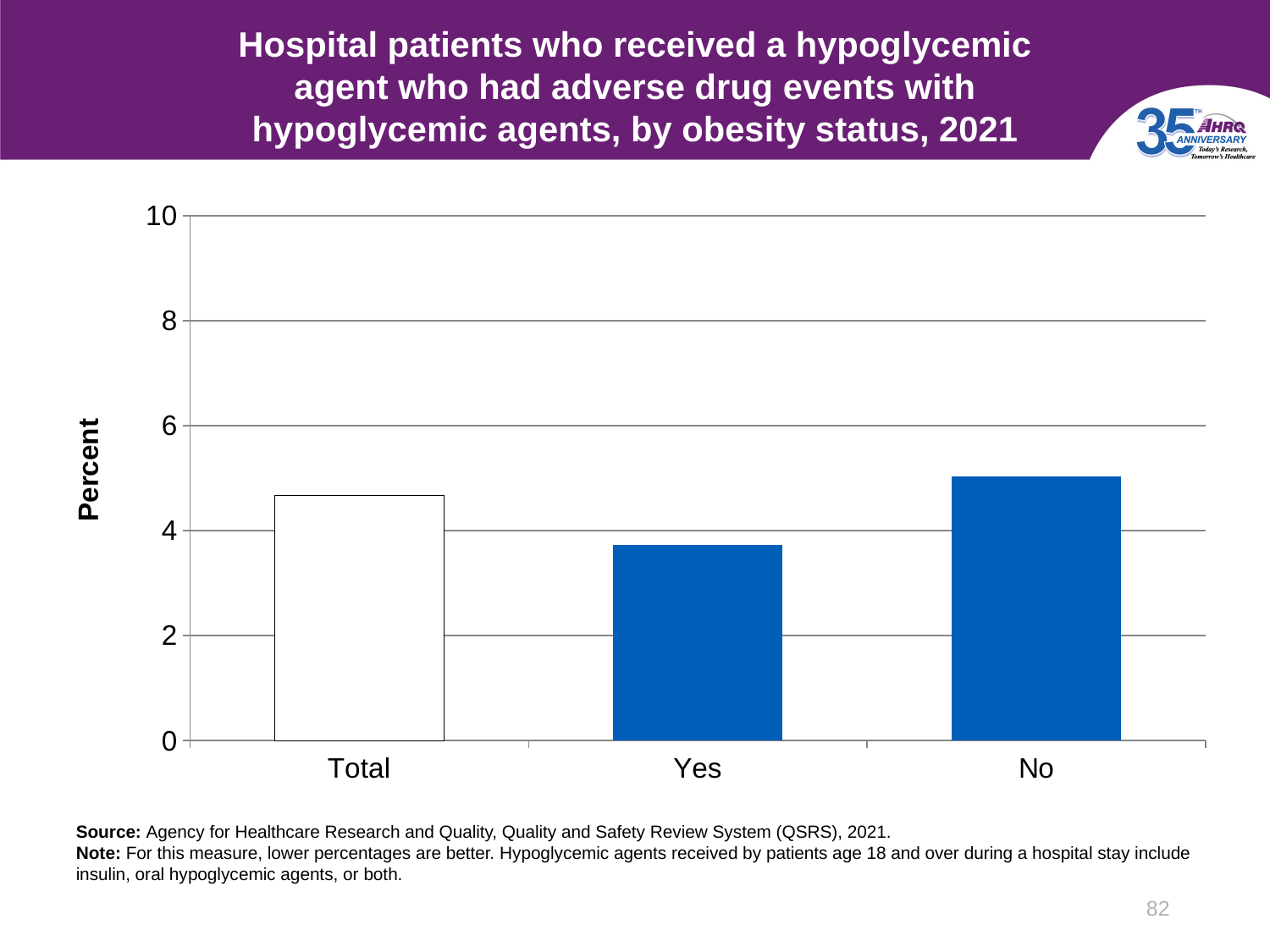
Is the value for No greater or less than 4? greater How many categories are shown on the x axis of the chart? 3 Is the value for Yes greater or less than 4? less Which is larger, the value for Total or the value for Yes? Total Is the value for No greater or less than 6? less Which is larger, the value for Yes or the value for No? No Which obesity status category has the highest percentage? No Which obesity status category has the lowest percentage? Yes What kind of chart is shown on the slide? Bar chart What year of data does the chart title say it shows? 2021 What is the label on the y axis of the chart? Percent